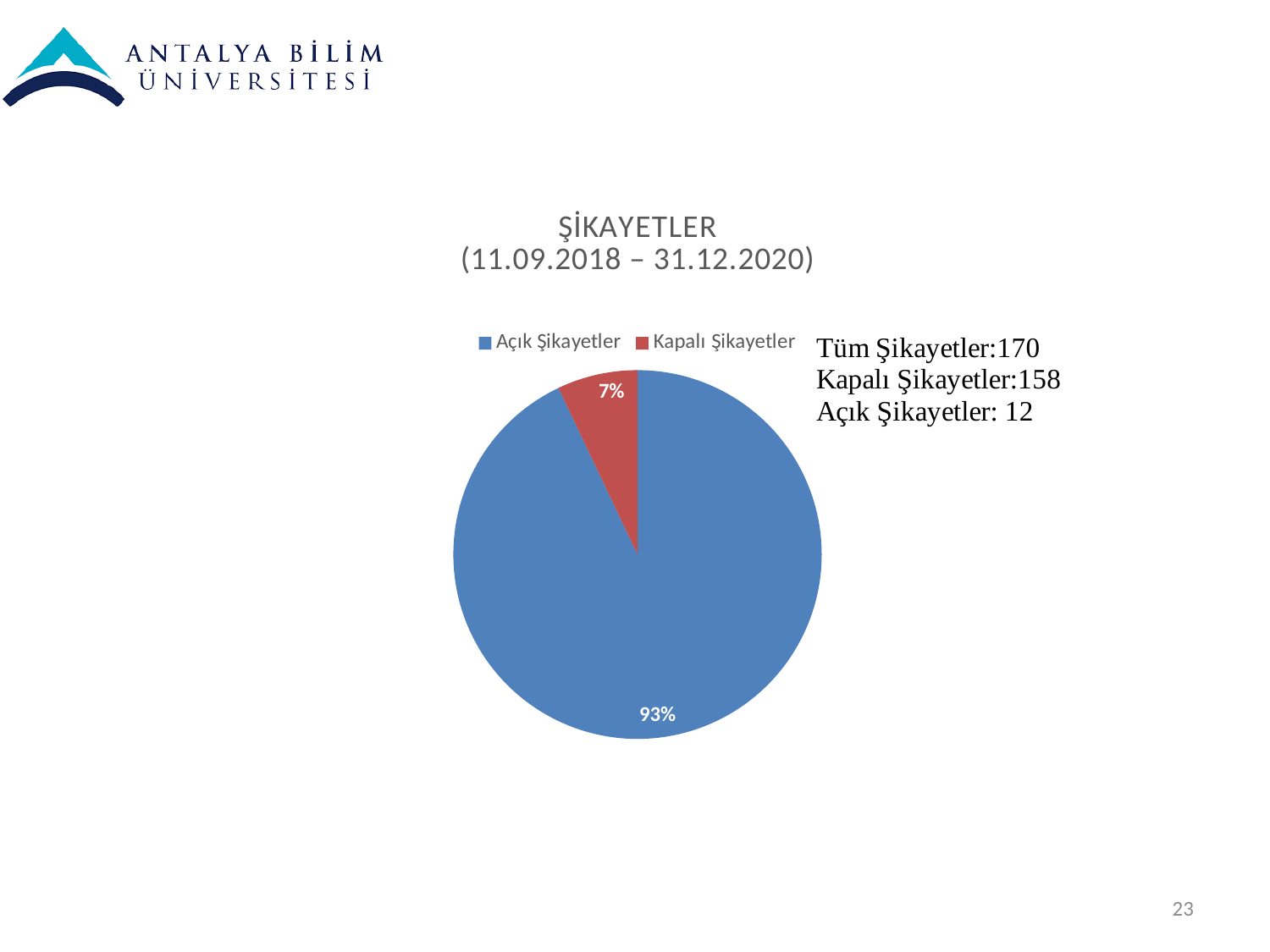
Which slice of the pie chart is larger, the blue one or the red one? blue What is the title of the chart? ŞİKAYETLER (11.09.2018 – 31.12.2020) What percentage is printed on the red slice of the pie chart? 7% What is the largest share shown on the pie chart? 93% According to the legend, which category is represented by the blue colour? Açık Şikayetler What percentage is printed on the blue slice of the pie chart? 93% What kind of chart is shown on the slide? pie chart How many slices does the pie chart have? 2 How many entries does the chart legend list? 2 What is the smallest share shown on the pie chart? 7% What is the difference in percentage points between the blue slice and the red slice? 86